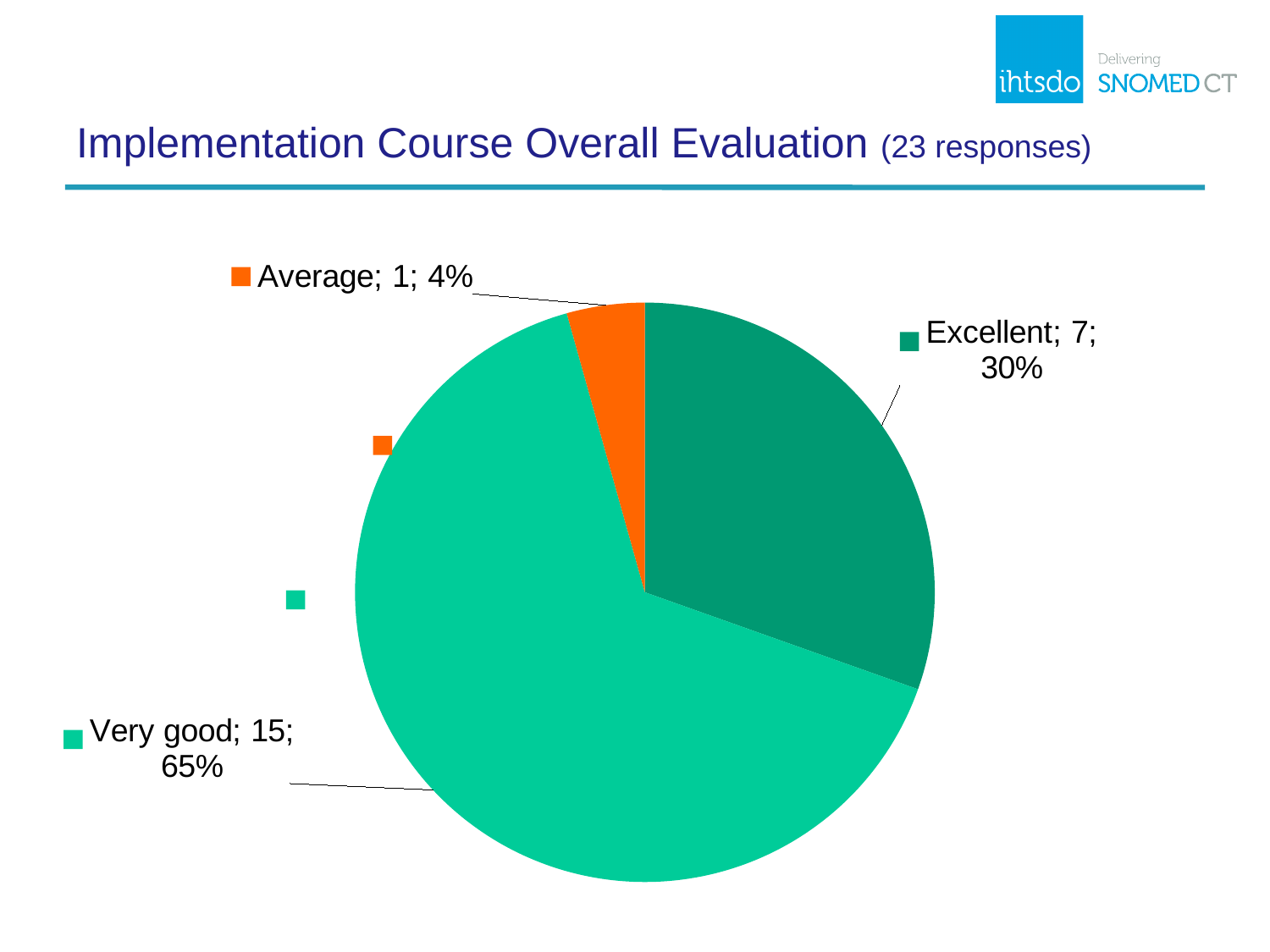
How many responses were rated Excellent? 7 What share of the pie does the Excellent slice represent? 30% What kind of chart is shown on the slide? pie chart How many more responses were Very good than Excellent? 8 How many categories are shown in the pie chart? 3 Which category has the smallest slice? Average What is the title of the slide? Implementation Course Overall Evaluation (23 responses) How many responses were rated Average? 1 Which has more responses, Excellent or Average? Excellent What percentage of responses were Very good? 65% What is the total number of responses across all slices? 23 Which category has the largest slice? Very good